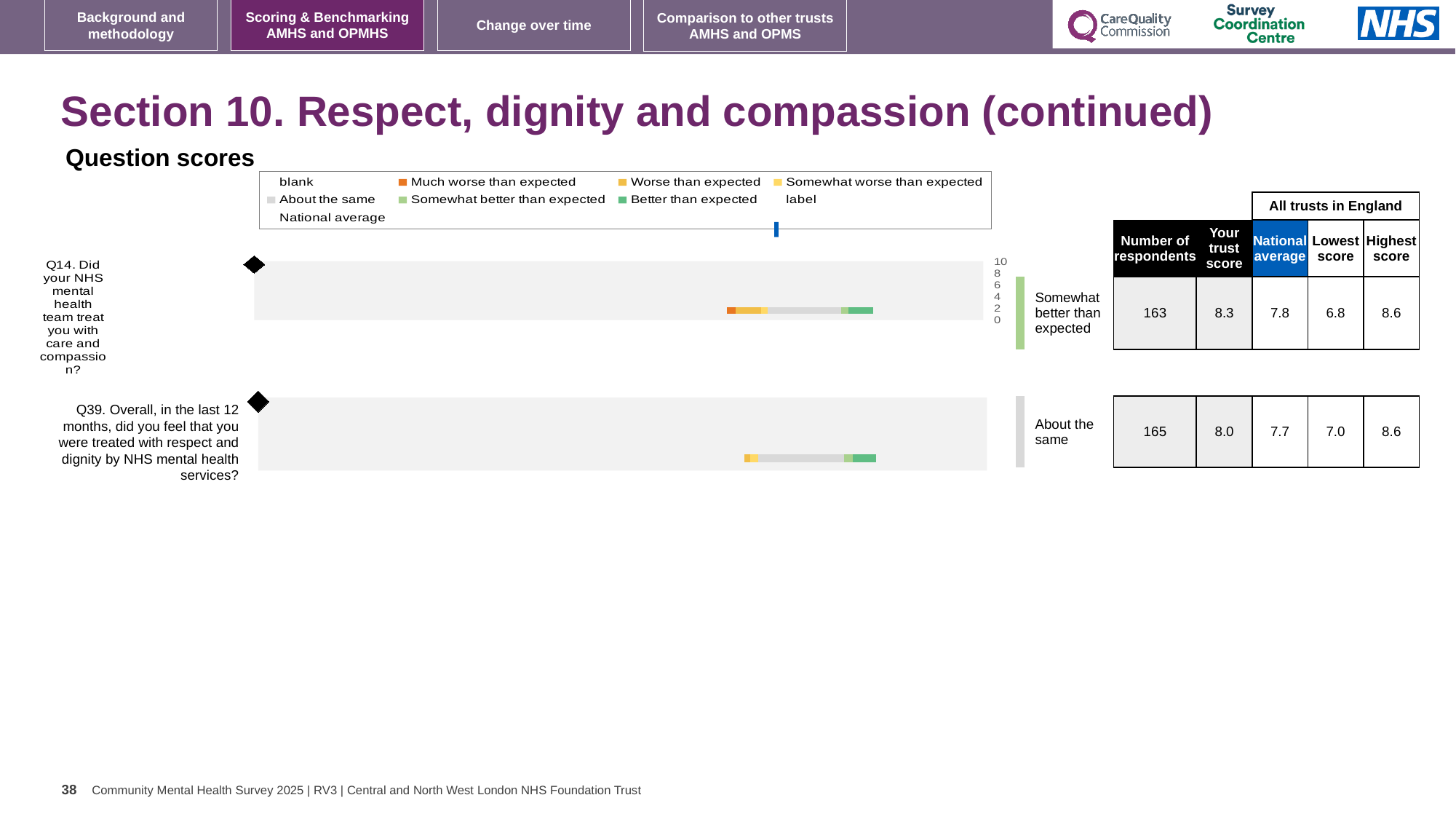
How many respondents answered Q39? 165 What kind of chart is used to show the question scores? Bar chart What benchmark category label is shown next to the Q14 bar? Somewhat better than expected Which is larger for Q14: the trust score or the national average? Trust score Which question has the higher lowest score across all trusts in England, Q14 or Q39? Q39 What is the difference between the trust score and the national average for Q14? 0.5 What is the highest score among all trusts in England for Q39? 8.6 What is the lowest score among all trusts in England for Q14? 6.8 What is the difference between the trust score and the national average for Q39? 0.3 How many questions are plotted on the slide? 2 What is the trust score for Q14 (Did your NHS mental health team treat you with care and compassion?)? 8.3 What is the national average score for Q39 (treated with respect and dignity by NHS mental health services)? 7.7